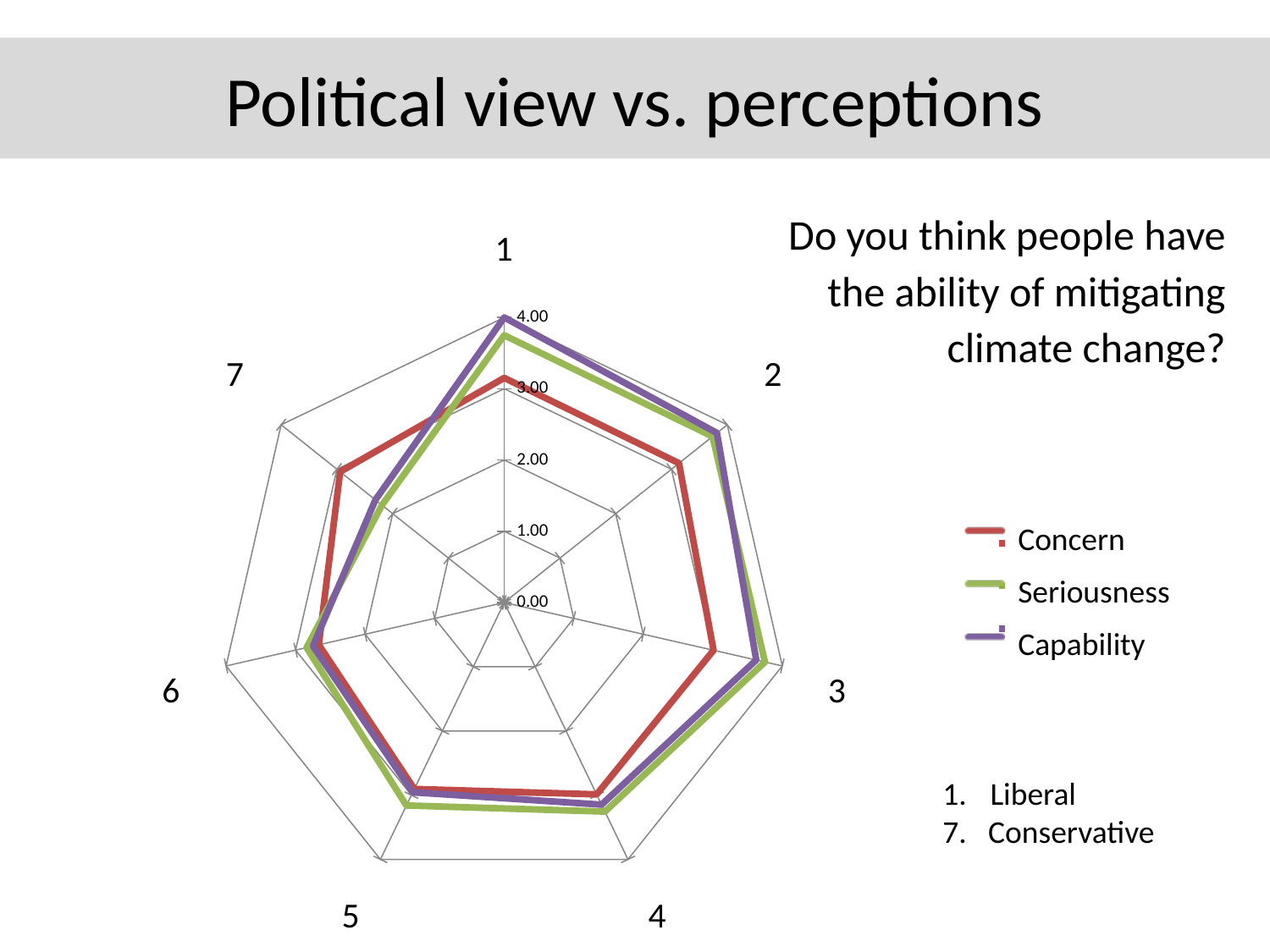
Which series are listed in the chart legend? Concern, Seriousness, Capability Is the Seriousness value for category 1 greater or less than 3.00? greater How many categories (axes) does the radar chart have? 7 Is the Seriousness value for category 2 greater or less than 3.00? greater At category 7, which series has the larger value, Concern or Seriousness? Concern How many series does the legend list? 3 What kind of chart is shown on the slide? Radar chart Is the Capability value for category 3 greater or less than 3.00? greater What is the highest value shown on the chart's radial axis? 4.00 At category 1, which series has the larger value, Capability or Concern? Capability For the Seriousness series, which category has the lowest value? 7